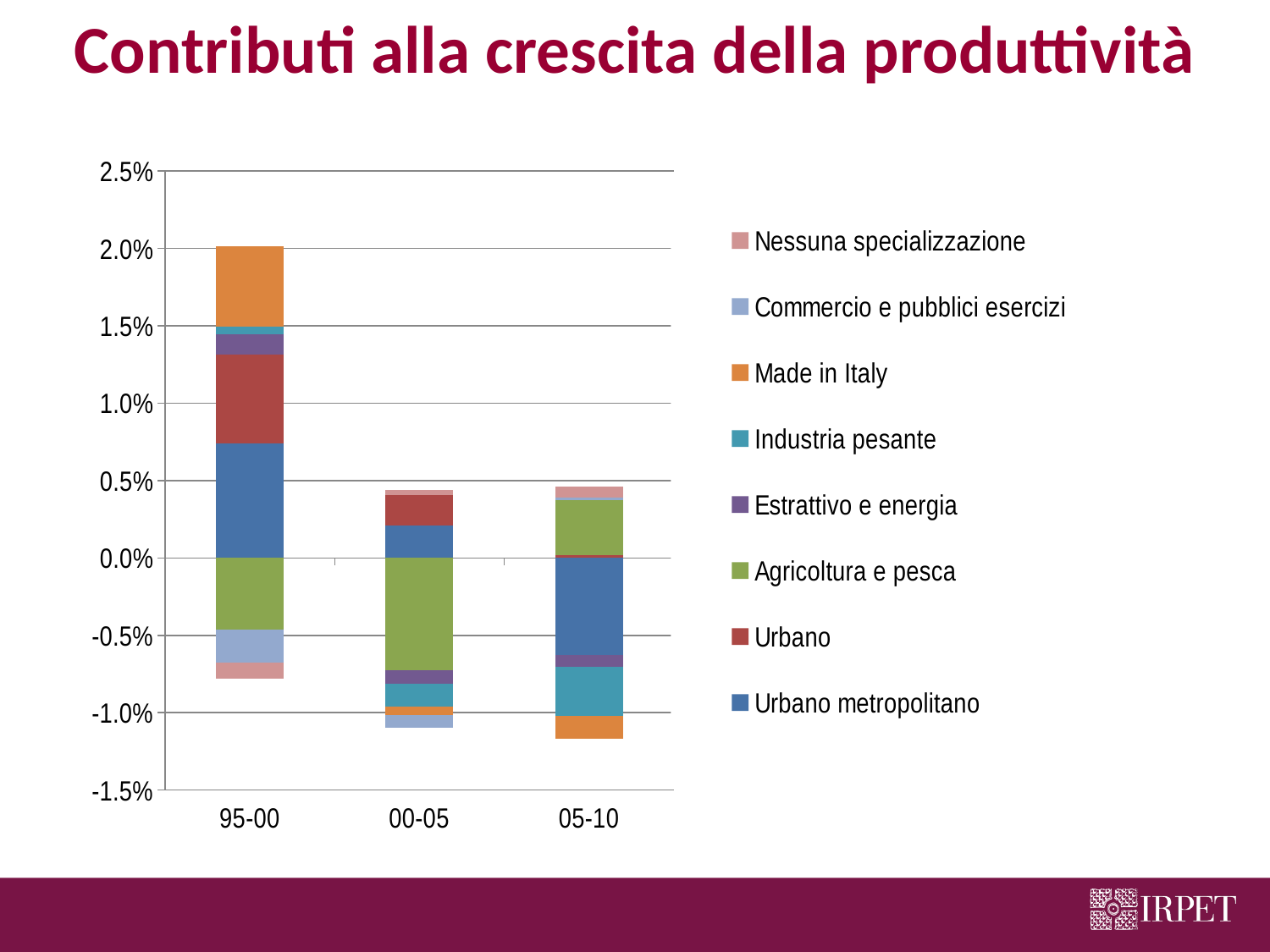
How many periods are shown on the x axis of the chart? 3 Is the contribution of Urbano metropolitano in 05-10 greater or less than -0.5%? less How many series does the chart's legend list? 8 Which period has the highest top of the positive stacked bar? 95-00 Is the contribution of Made in Italy in 95-00 greater or less than 0.0%? greater Which legend entry is shown in orange? Made in Italy Is the top of the positive stack in 00-05 greater or less than 0.5%? less What kind of chart is shown on the slide? Stacked bar chart What is the title of the slide containing the chart? Contributi alla crescita della produttività